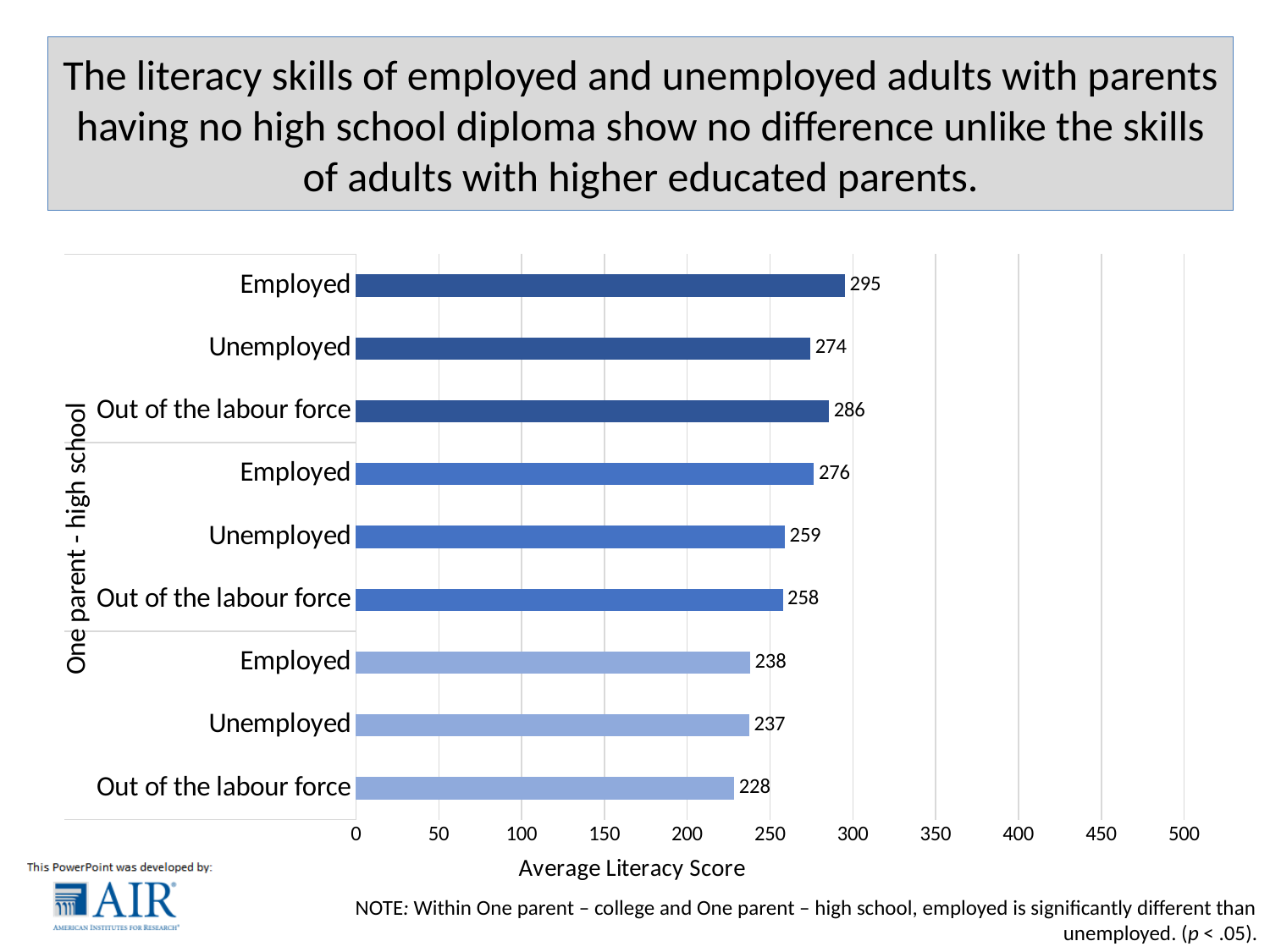
How many bars are plotted in the chart? 9 Which bar has the lowest average literacy score? Out of the labour force (bottom group), 228 What is the difference between the Employed and Unemployed scores in the top (darkest blue) group? 21 Which is larger: the Out of the labour force score in the top group or the Employed score in the middle group? Out of the labour force in the top group (286) What kind of chart is shown on the slide? bar chart Which bar has the highest average literacy score? Employed (top group), 295 What is the title of the horizontal axis? Average Literacy Score What is the average literacy score for the Unemployed bar in the bottom (lightest blue) group? 237 What is the average literacy score for the Unemployed bar in the middle group? 259 What is the difference between the Employed and Unemployed scores in the bottom (lightest blue) group? 1 Is the Employed score in the bottom (lightest blue) group greater or less than 250? less What is the average literacy score for the Employed bar in the top (darkest blue) group? 295